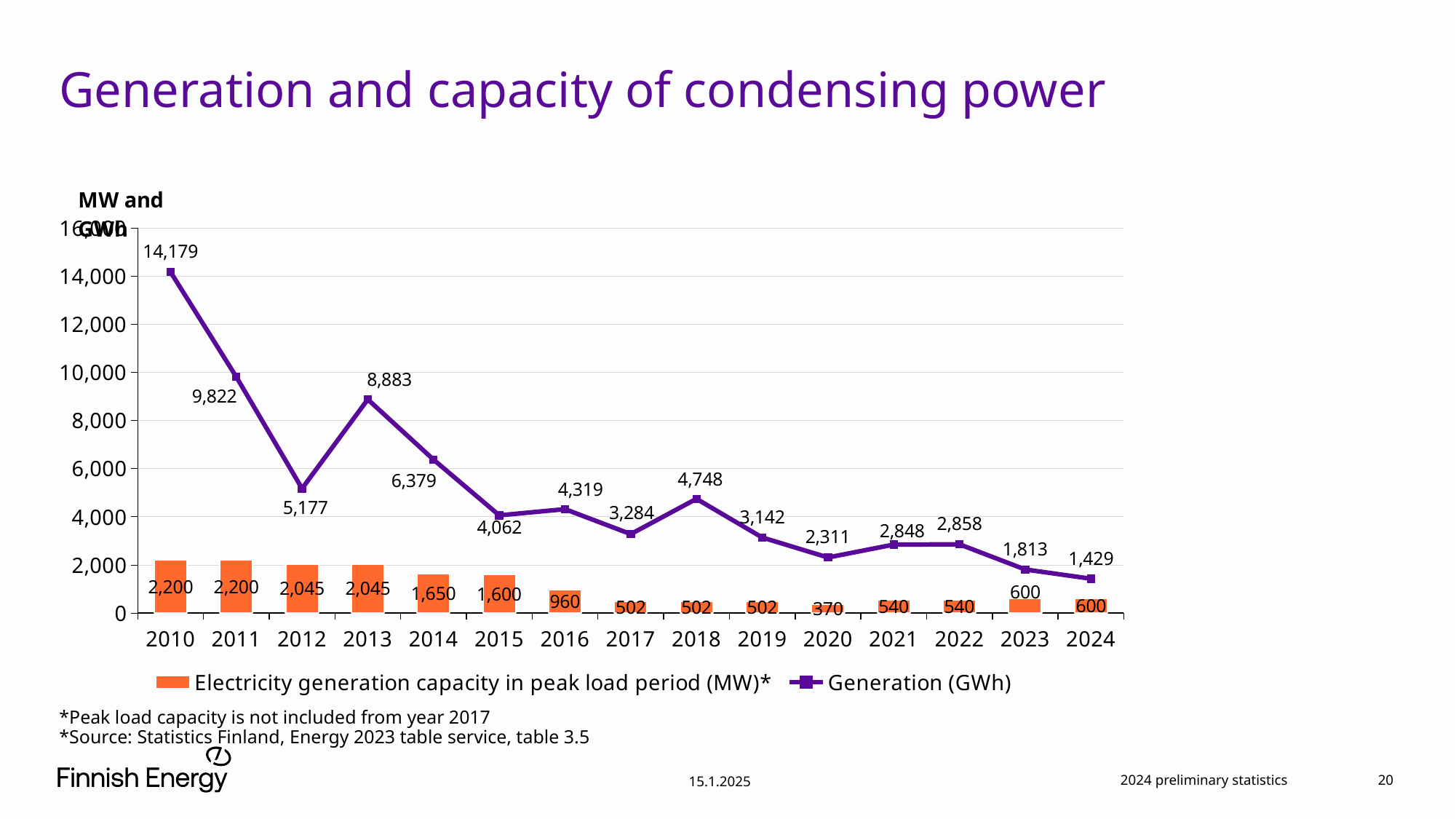
Which year had higher generation (GWh), 2016 or 2018? 2018 How many years are shown on the x axis? 15 Which year had the highest generation (GWh)? 2010 How many series does the legend list? 2 What was the electricity generation capacity in peak load period (MW) in 2014? 1,650 What was the generation (GWh) in 2024? 1,429 Does the generation (GWh) generally rise or fall from 2010 to 2024? Fall What kind of chart is used for the Generation (GWh) series? Line chart What is the difference in generation (GWh) between 2013 and 2012? 3,706 What is the title of the chart? Generation and capacity of condensing power What was the generation (GWh) in 2010? 14,179 Which year had the lowest electricity generation capacity in peak load period (MW)? 2020